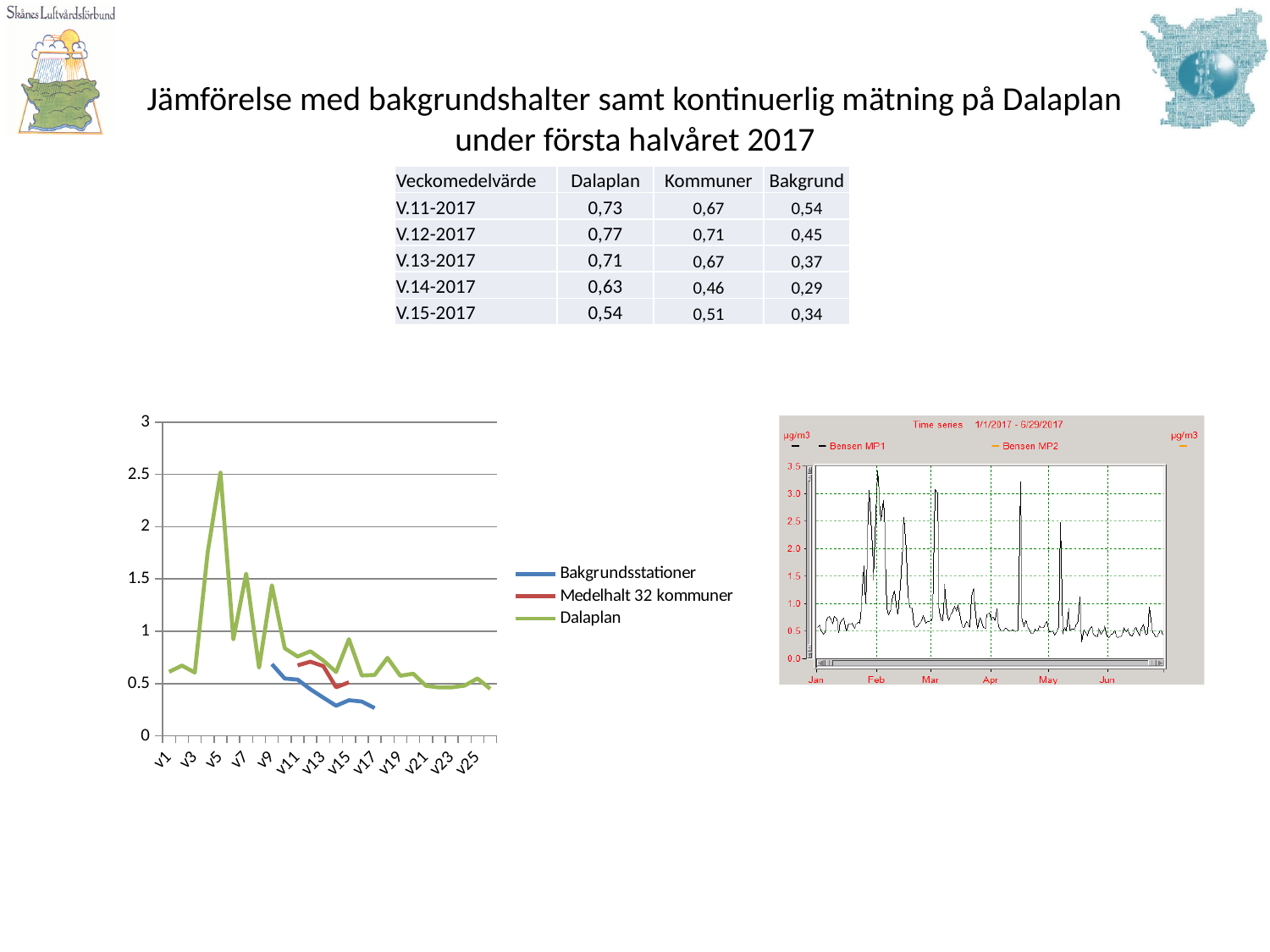
What kind of chart is the chart on the right of the slide? line chart What date range is shown in the title of the right chart? 1/1/2017 - 6/29/2017 What are the three series named in the legend of the left chart? Bakgrundsstationer, Medelhalt 32 kommuner, Dalaplan In the left chart, which series reaches the highest value? Dalaplan In the left chart, at which week does the Dalaplan series reach its peak? v5 In the left chart, is the Dalaplan value at v5 greater or less than 2? greater In the left chart, at v13, which series is higher: Medelhalt 32 kommuner or Bakgrundsstationer? Medelhalt 32 kommuner In the left chart, does the Bakgrundsstationer series rise or fall from v9 to v17? fall What kind of chart is the chart on the left of the slide? line chart In the left chart, is the Bakgrundsstationer value at v17 greater or less than 0.5? less How many series does the legend of the right chart list? 2 How many series does the legend of the left chart list? 3